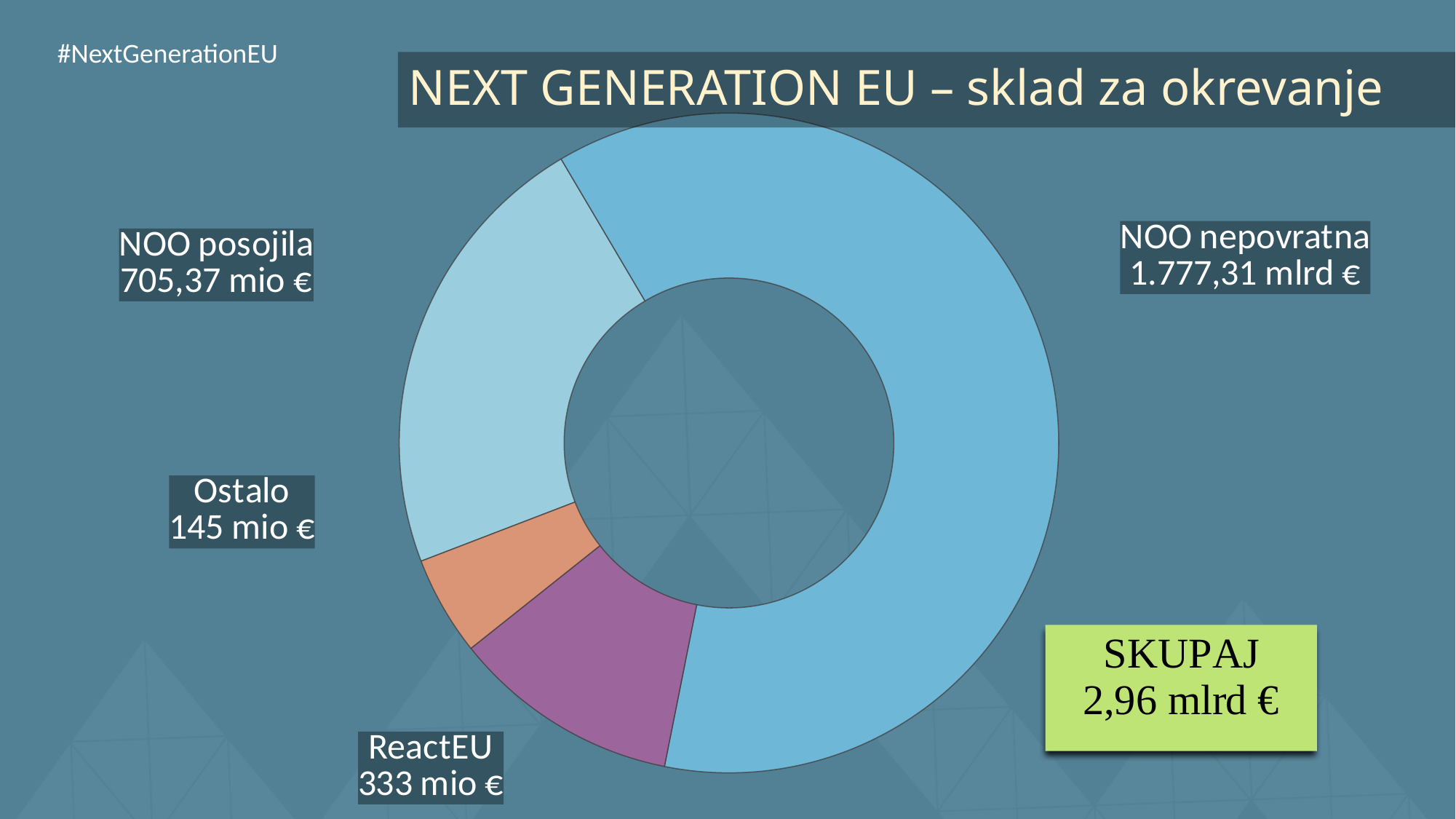
How many segments does the donut chart have? 4 What total (SKUPAJ) is shown on the slide? 2,96 mlrd € What is the value shown for ReactEU? 333 mio € What is the title of the chart on the slide? NEXT GENERATION EU – sklad za okrevanje What is the value shown for NOO nepovratna? 1.777,31 mlrd € Which segment of the chart is the smallest? Ostalo What is the value shown for Ostalo? 145 mio € What is the value shown for NOO posojila? 705,37 mio € What kind of chart is shown on the slide? Donut (pie) chart What is the difference between NOO posojila and ReactEU? 372,37 mio € Which is larger, ReactEU or Ostalo? ReactEU Which segment of the chart is the largest? NOO nepovratna